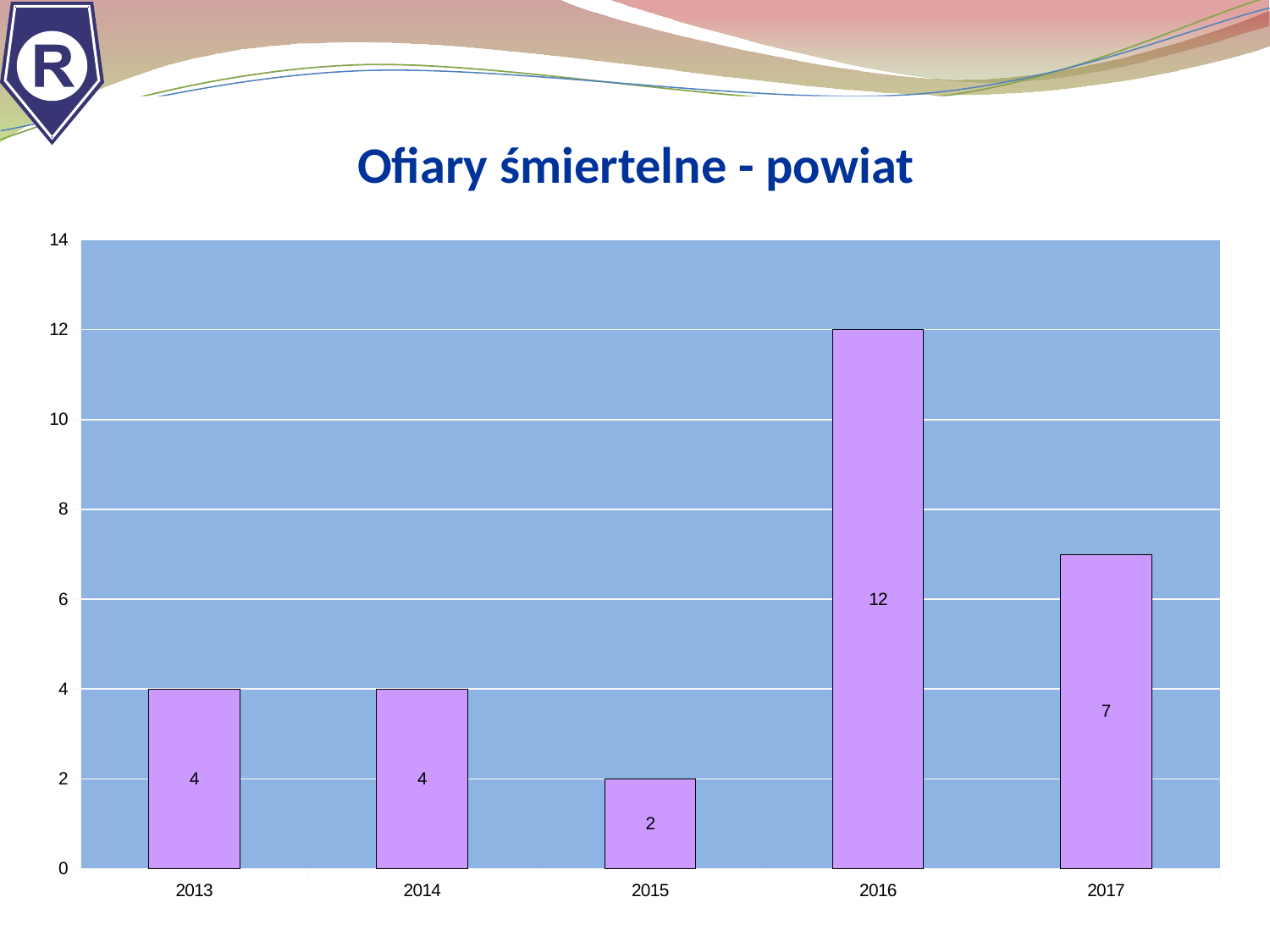
What is the value for 2017? 7 How many years are shown on the x axis? 5 What is the value for 2015? 2 Which year has the lowest value? 2015 What is the difference between the values for 2013 and 2015? 2 Is the value for 2016 greater or less than 10? greater What is the value for 2016? 12 What kind of chart is shown? bar chart What is the title of the chart? Ofiary śmiertelne - powiat What is the difference between the values for 2016 and 2017? 5 Which is larger, the value for 2014 or the value for 2017? 2017 Which year has the highest value? 2016